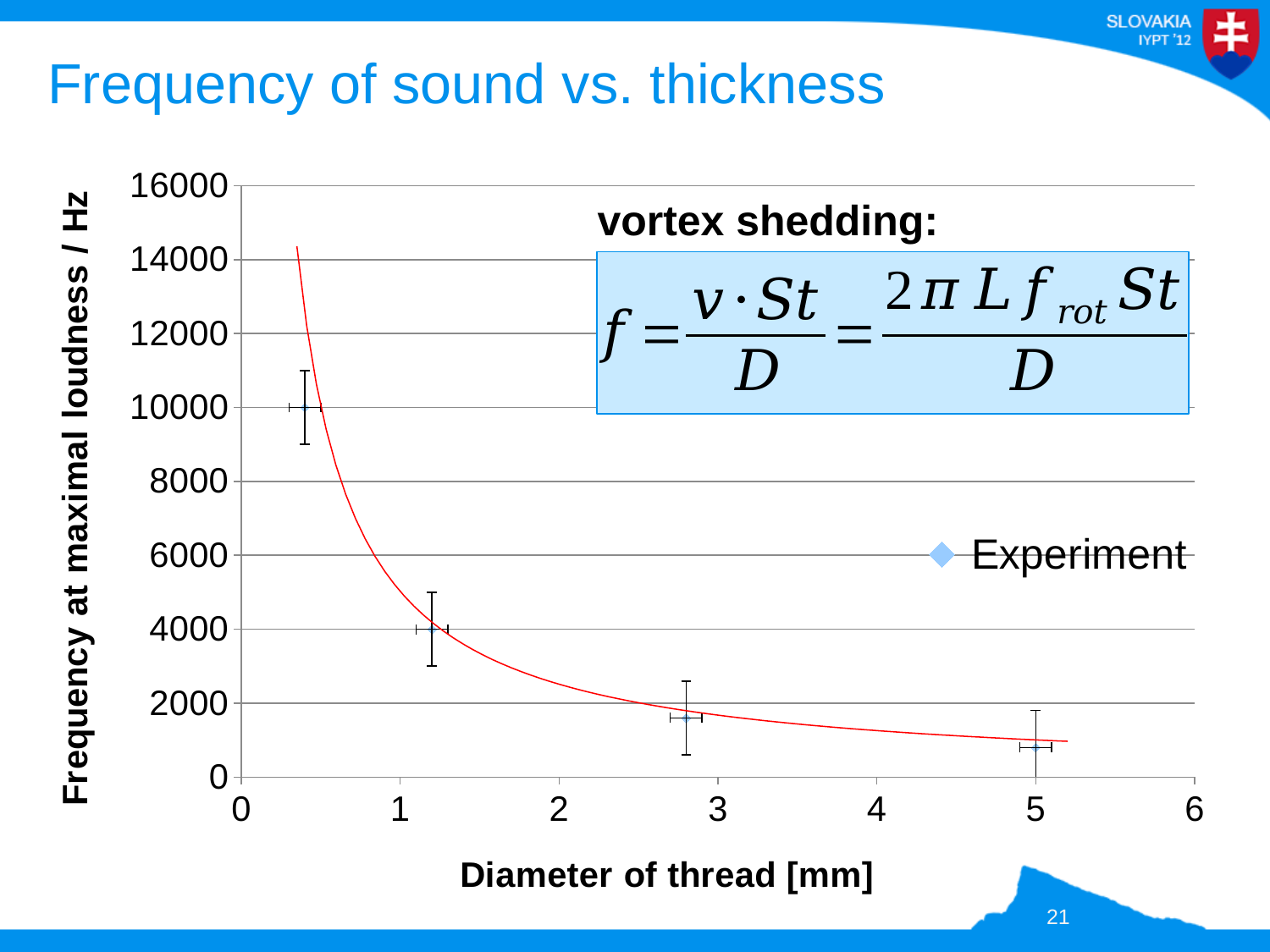
How many series does the chart legend list? 1 Is the frequency of the third data point from the left (near 3 mm) greater or less than 4000? less What is the frequency of the second data point from the left? 4000 What is the name of the series shown in the legend? Experiment Is the frequency of the rightmost data point (near 5 mm) greater or less than 2000? less What is the frequency of the leftmost data point (the one at the smallest diameter)? 10000 How many experimental data points are plotted on the chart? 4 Which data point has the highest frequency: the leftmost one or the rightmost one? the leftmost one Do the plotted frequency values rise or fall as the diameter of thread increases? fall Is the frequency of the leftmost data point greater or less than 8000? greater What kind of chart is shown on the slide? scatter chart What is the title of the x axis? Diameter of thread [mm]